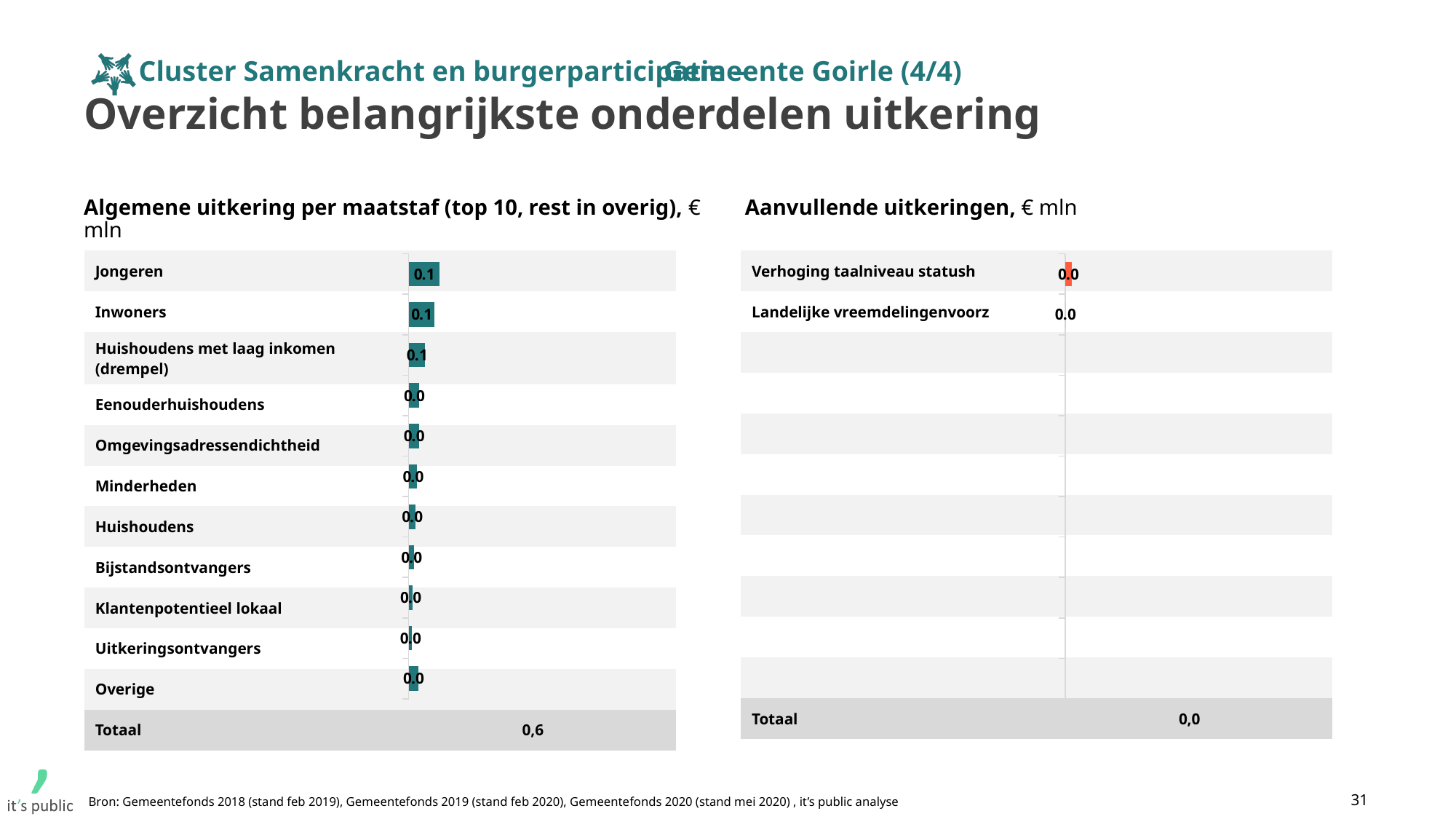
In the chart 'Algemene uitkering per maatstaf', what is the value for Minderheden? 0.0 In the chart 'Aanvullende uitkeringen', what is the value for Verhoging taalniveau statush? 0.0 In the chart 'Algemene uitkering per maatstaf', which is larger: the value for Jongeren or the value for Uitkeringsontvangers? Jongeren How many categories (including Overige) are plotted in the chart 'Algemene uitkering per maatstaf'? 11 In the chart 'Algemene uitkering per maatstaf', what is the value for Huishoudens met laag inkomen (drempel)? 0.1 In the chart 'Algemene uitkering per maatstaf', what is the value for Inwoners? 0.1 In the chart 'Algemene uitkering per maatstaf', what is the value shown for Totaal? 0,6 What kind of chart is 'Algemene uitkering per maatstaf'? Bar chart In the chart 'Aanvullende uitkeringen', what is the value shown for Totaal? 0,0 In the chart 'Algemene uitkering per maatstaf', what is the value for Jongeren? 0.1 How many categories are plotted in the chart 'Aanvullende uitkeringen'? 2 In the chart 'Aanvullende uitkeringen', what is the value for Landelijke vreemdelingenvoorz? 0.0